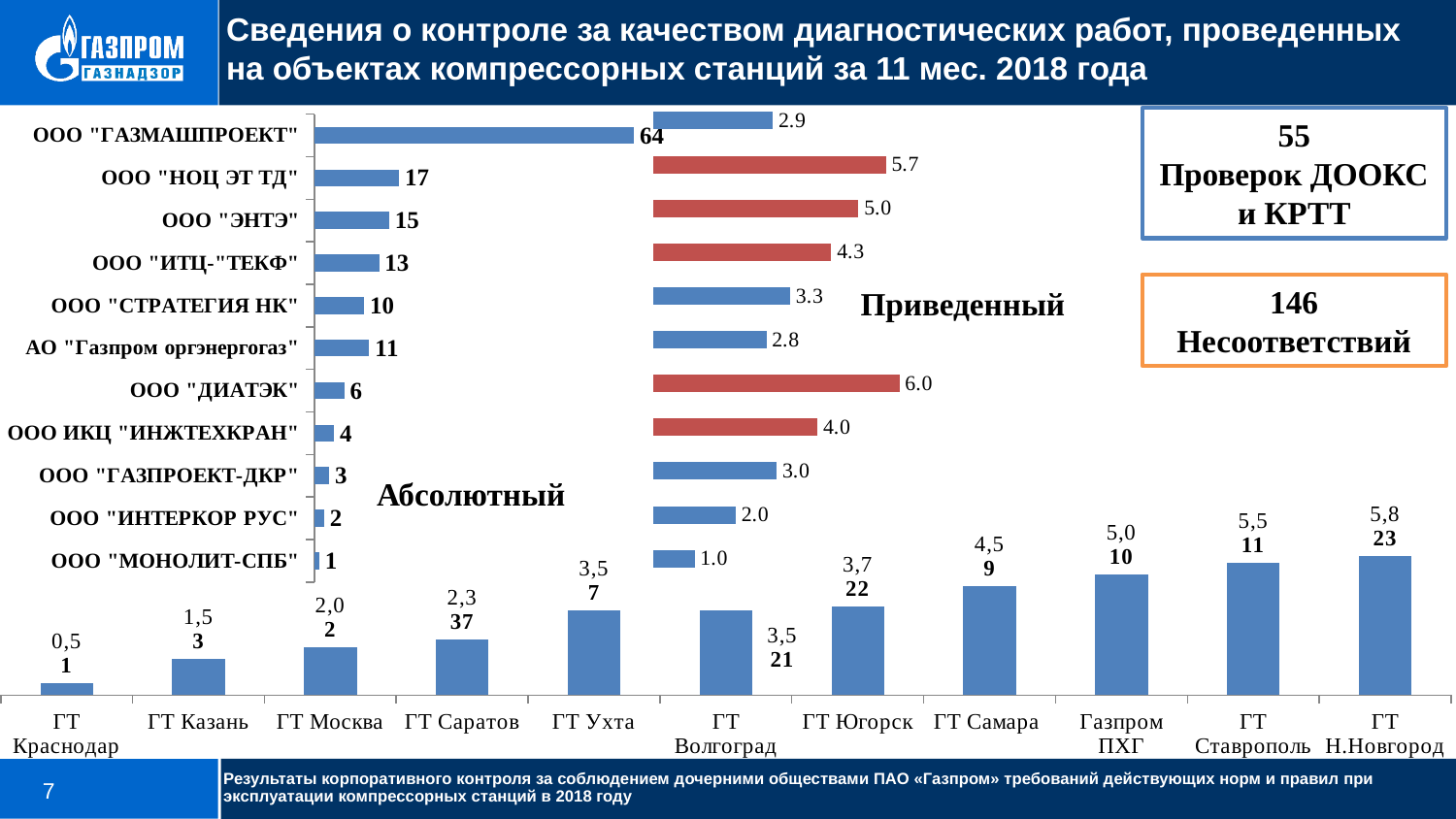
What type of chart is the bottom chart of ГТ stations? bar chart In the bottom chart of ГТ stations, what is the non-bold value shown above the bar for ГТ Н.Новгород? 5,8 In the 'Приведенный' bar chart, what is the highest value shown? 6.0 In the 'Абсолютный' bar chart, which category has the highest value? ООО "ГАЗМАШПРОЕКТ" In the bottom chart of ГТ stations, what is the bold value shown for ГТ Саратов? 37 In the 'Абсолютный' bar chart, what is the difference between the values for ООО "НОЦ ЭТ ТД" and ООО "ИТЦ-"ТЕКФ"? 4 In the 'Абсолютный' bar chart, what is the value for ООО "ЭНТЭ"? 15 In the 'Абсолютный' bar chart, which is larger: the value for ООО "СТРАТЕГИЯ НК" or for АО "Газпром оргэнергогаз"? АО "Газпром оргэнергогаз" In the 'Абсолютный' bar chart, what is the value for ООО "ГАЗМАШПРОЕКТ"? 64 In the 'Абсолютный' bar chart, which category has the lowest value? ООО "МОНОЛИТ-СПБ" In the 'Приведенный' bar chart, what is the lowest value shown? 1.0 How many categories are shown in the 'Абсолютный' bar chart? 11